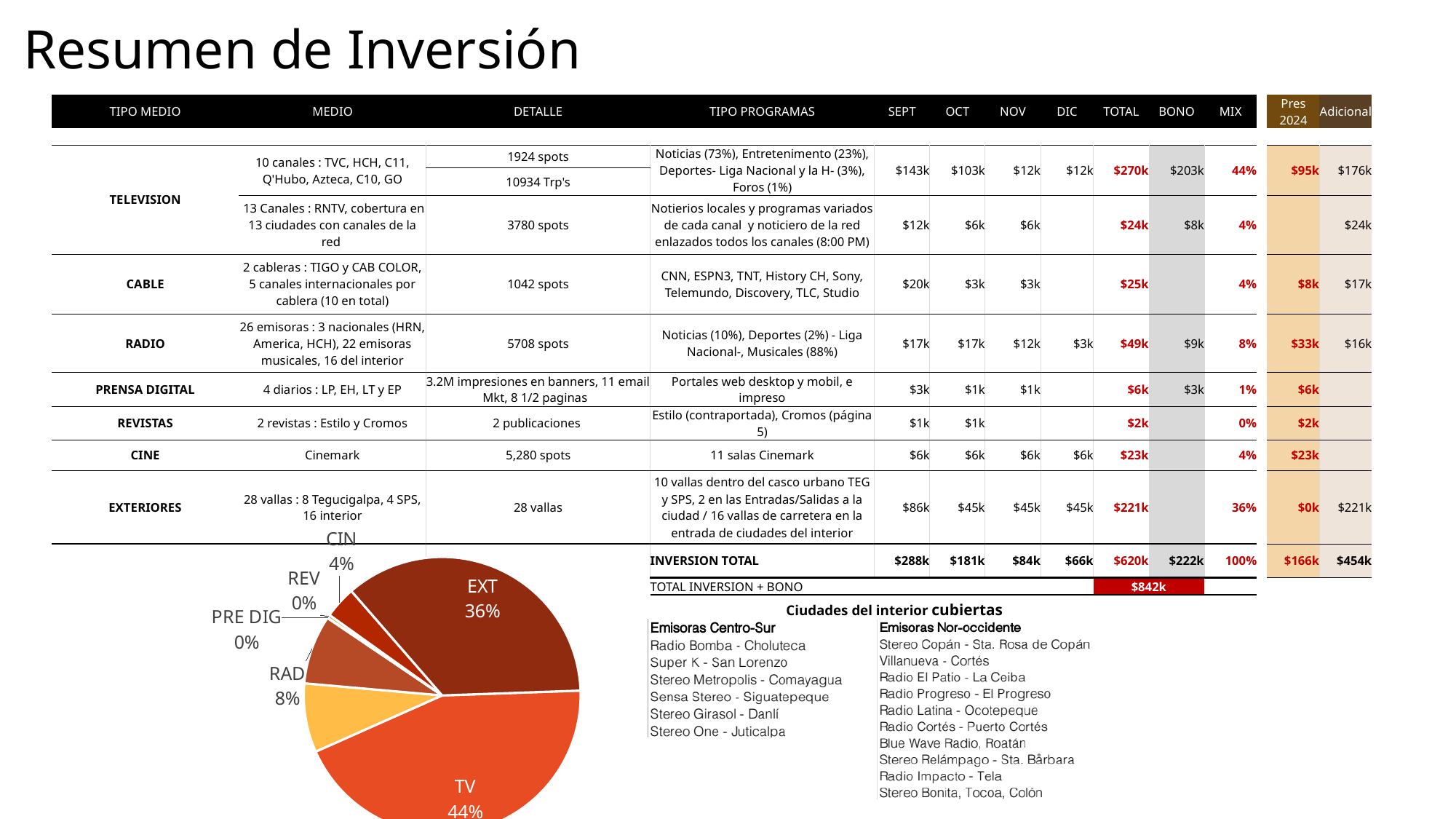
Which slice is larger in the pie chart, EXT or RAD? EXT What percentage is shown for CIN in the pie chart? 4% What type of chart is shown on the slide? Pie chart What percentage is shown for REV in the pie chart? 0% Which category has the largest slice in the pie chart? TV What share of the pie chart does TV represent? 44% What percentage is shown for PRE DIG in the pie chart? 0% By how many percentage points does the TV slice exceed the EXT slice in the pie chart? 8 percentage points What is the combined share of TV and EXT in the pie chart? 80% What percentage is shown for EXT in the pie chart? 36% What percentage is shown for RAD in the pie chart? 8% Which slice is larger in the pie chart, RAD or CIN? RAD